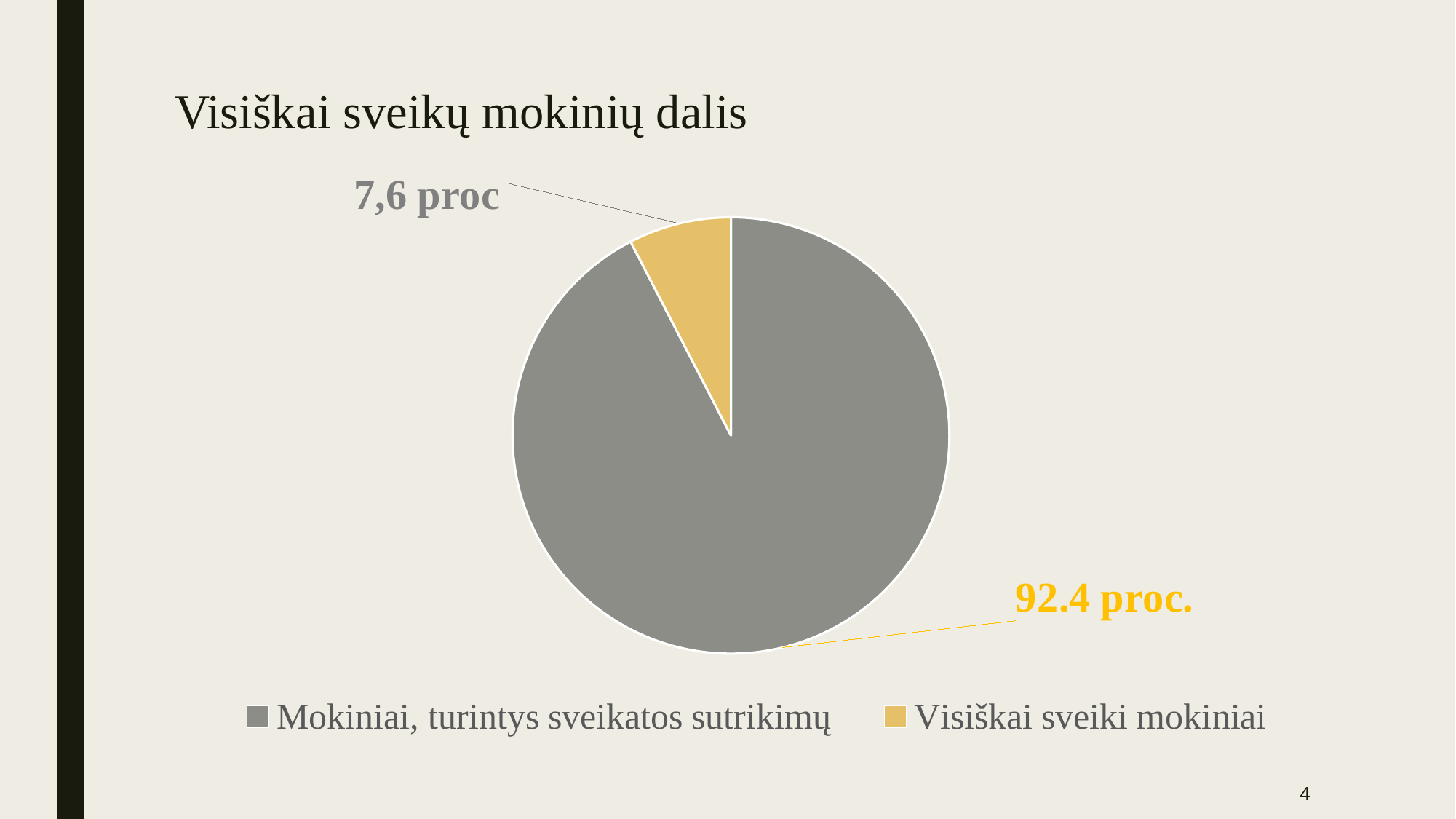
What is the title of the chart? Visiškai sveikų mokinių dalis Is the share for Visiškai sveiki mokiniai greater or less than 10 percent? less What kind of chart is shown on the slide? pie chart Which colour represents Visiškai sveiki mokiniai in the legend? yellow Which category has the smallest slice of the pie? Visiškai sveiki mokiniai Which slice is larger: Mokiniai, turintys sveikatos sutrikimų or Visiškai sveiki mokiniai? Mokiniai, turintys sveikatos sutrikimų How many entries does the legend list? 2 How many slices does the pie chart have? 2 What share of the pie is labelled for the large grey slice (Mokiniai, turintys sveikatos sutrikimų)? 92.4 proc. Which category has the largest slice of the pie? Mokiniai, turintys sveikatos sutrikimų What share of the pie is labelled for the small yellow slice (Visiškai sveiki mokiniai)? 7,6 proc